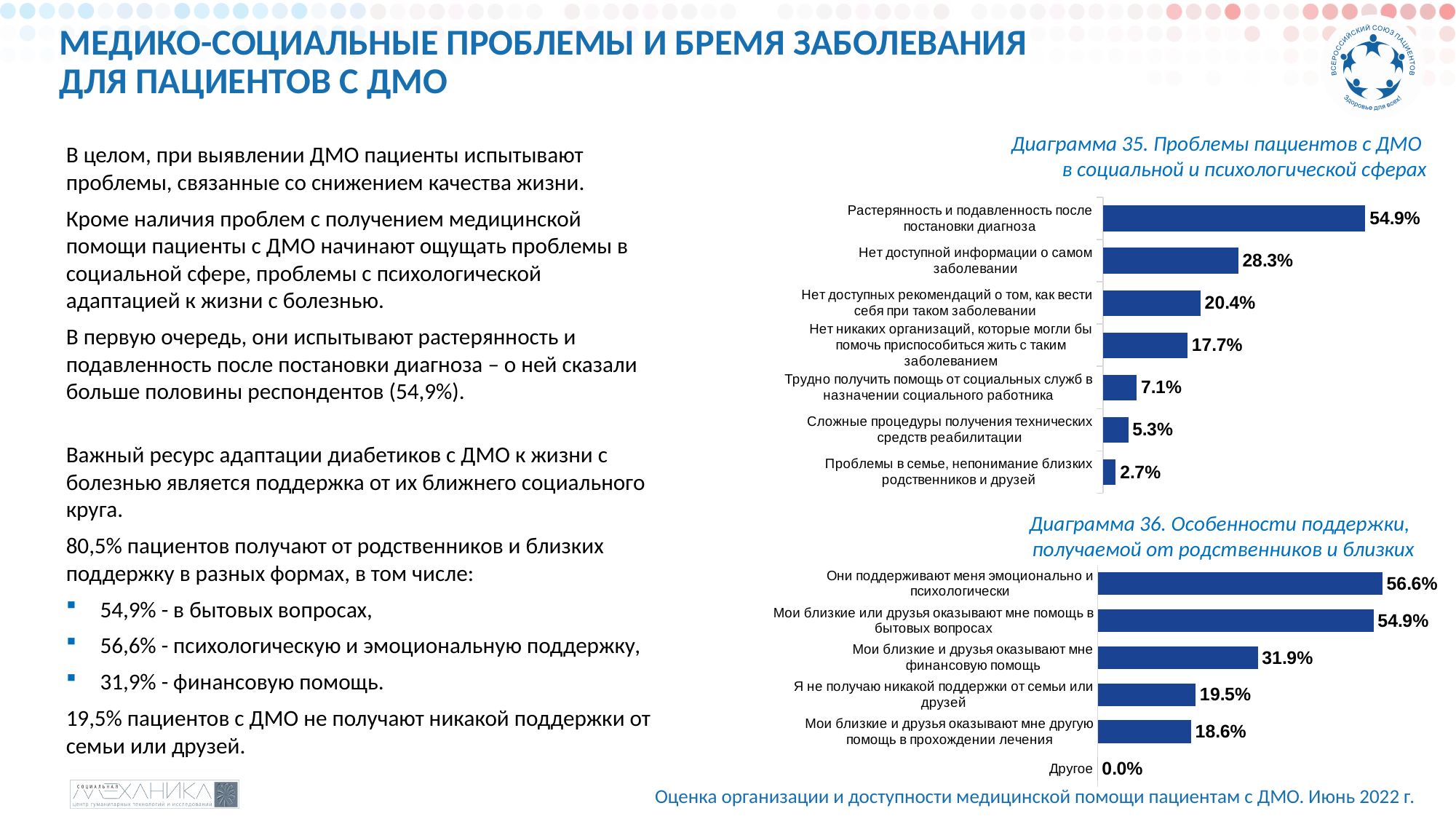
In Диаграмма 35, what is the difference between «Нет доступной информации о самом заболевании» and «Нет доступных рекомендаций о том, как вести себя при таком заболевании»? 7.9% In Диаграмма 36, what is the value for «Мои близкие и друзья оказывают мне финансовую помощь»? 31.9% In Диаграмма 35, which category has the lowest value? Проблемы в семье, непонимание близких родственников и друзей In Диаграмма 36, which category has the highest value? Они поддерживают меня эмоционально и психологически In Диаграмма 35, what is the value for «Растерянность и подавленность после постановки диагноза»? 54.9% In Диаграмма 35, which is larger: «Трудно получить помощь от социальных служб в назначении социального работника» or «Сложные процедуры получения технических средств реабилитации»? Трудно получить помощь от социальных служб в назначении социального работника In Диаграмма 36, what is the value for «Другое»? 0.0% In Диаграмма 36, what is the difference between «Я не получаю никакой поддержки от семьи или друзей» and «Мои близкие и друзья оказывают мне другую помощь в прохождении лечения»? 0.9% In Диаграмма 35, what is the value for «Нет доступной информации о самом заболевании»? 28.3% In Диаграмма 35, how many categories are shown? 7 What type of chart is Диаграмма 36? Bar chart In Диаграмма 36, how many categories are shown? 6